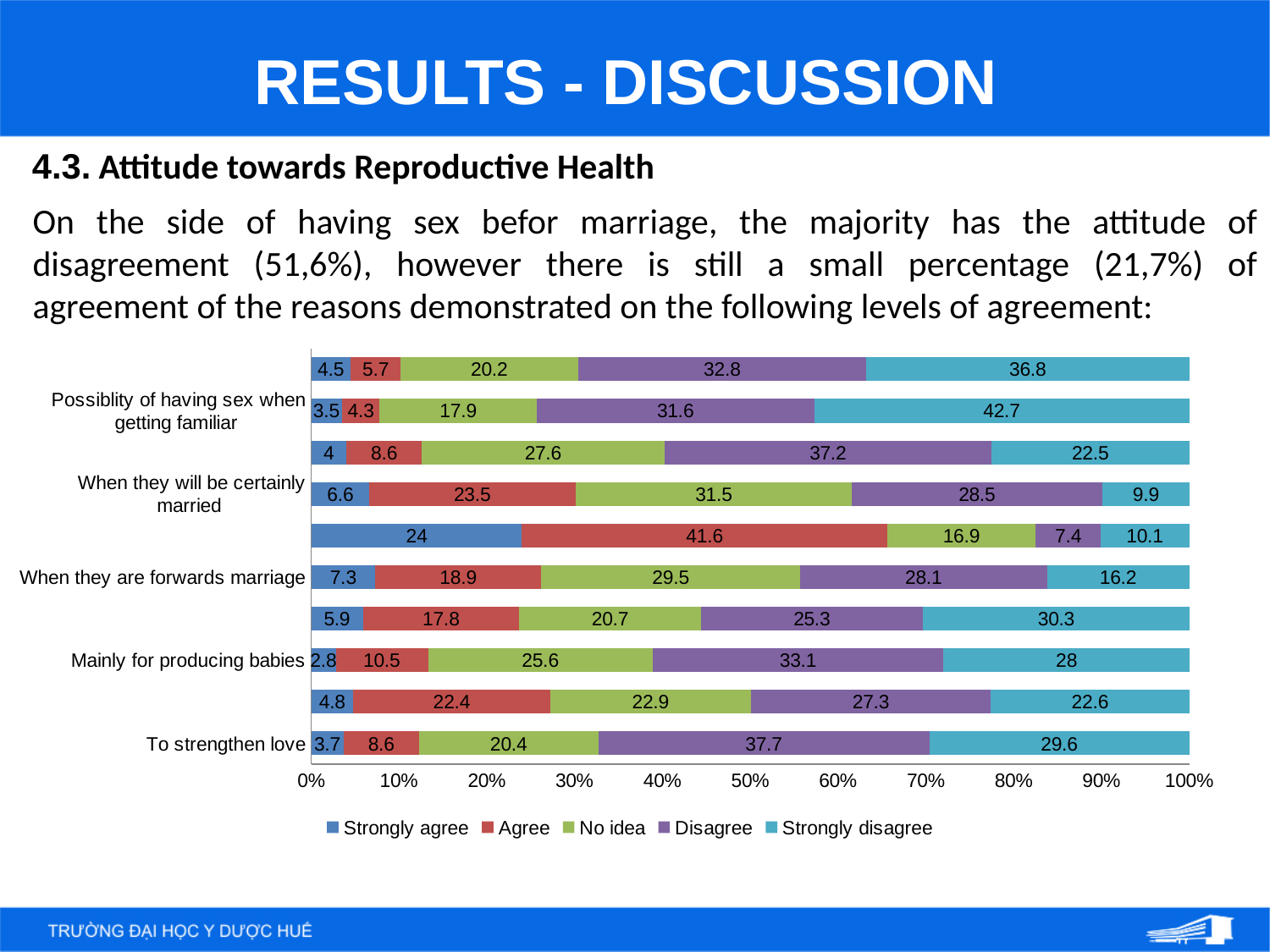
What is the highest value shown on the x axis? 100% How many bars are plotted in the chart? 10 What is the Agree value for the bar labelled 'When they will be certainly married'? 23.5 What kind of chart is shown on the slide? Stacked bar chart What is the Strongly disagree value for the bar labelled 'To strengthen love'? 29.6 What is the No idea value for the bar labelled 'Mainly for producing babies'? 25.6 Which series is shown in red in the legend? Agree For the bar labelled 'To strengthen love', which is larger: the Disagree value or the Strongly disagree value? Disagree What is the Strongly disagree value for the bar labelled 'Possiblity of having sex when getting familiar'? 42.7 What is the Disagree value for the bar labelled 'To strengthen love'? 37.7 How many series does the legend list? 5 For the bar labelled 'When they are forwards marriage', what is the difference between the No idea value (29.5) and the Agree value (18.9)? 10.6